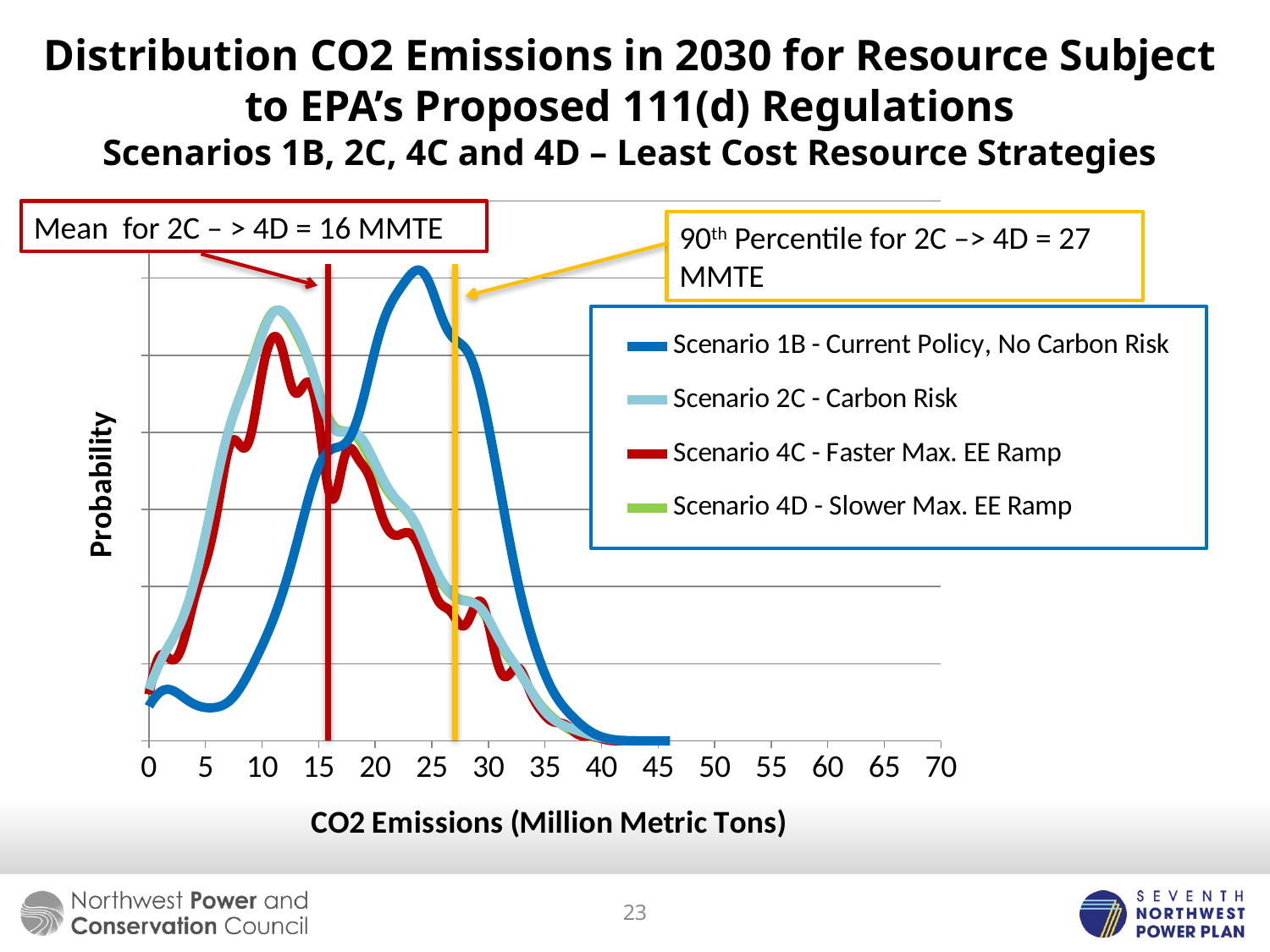
According to the annotation, what is the 90th percentile CO2 emissions for scenarios 2C through 4D? 27 MMTE What is the title of the x axis? CO2 Emissions (Million Metric Tons) What is the title of the y axis? Probability Is the CO2 emissions value at which Scenario 2C peaks greater or less than 15? less What kind of chart is shown on the slide? Line chart What is the highest value labelled on the x axis? 70 Which series peaks at a higher CO2 emissions value, Scenario 1B or Scenario 4C? Scenario 1B According to the annotation, what is the mean CO2 emissions for scenarios 2C through 4D? 16 MMTE Which series reaches its peak probability at the highest CO2 emissions value? Scenario 1B - Current Policy, No Carbon Risk Is the CO2 emissions value at which Scenario 1B peaks greater or less than 20? greater How many series does the legend list? 4 Do the probability values for Scenario 1B rise or fall as CO2 emissions increase from 30 to 40? Fall